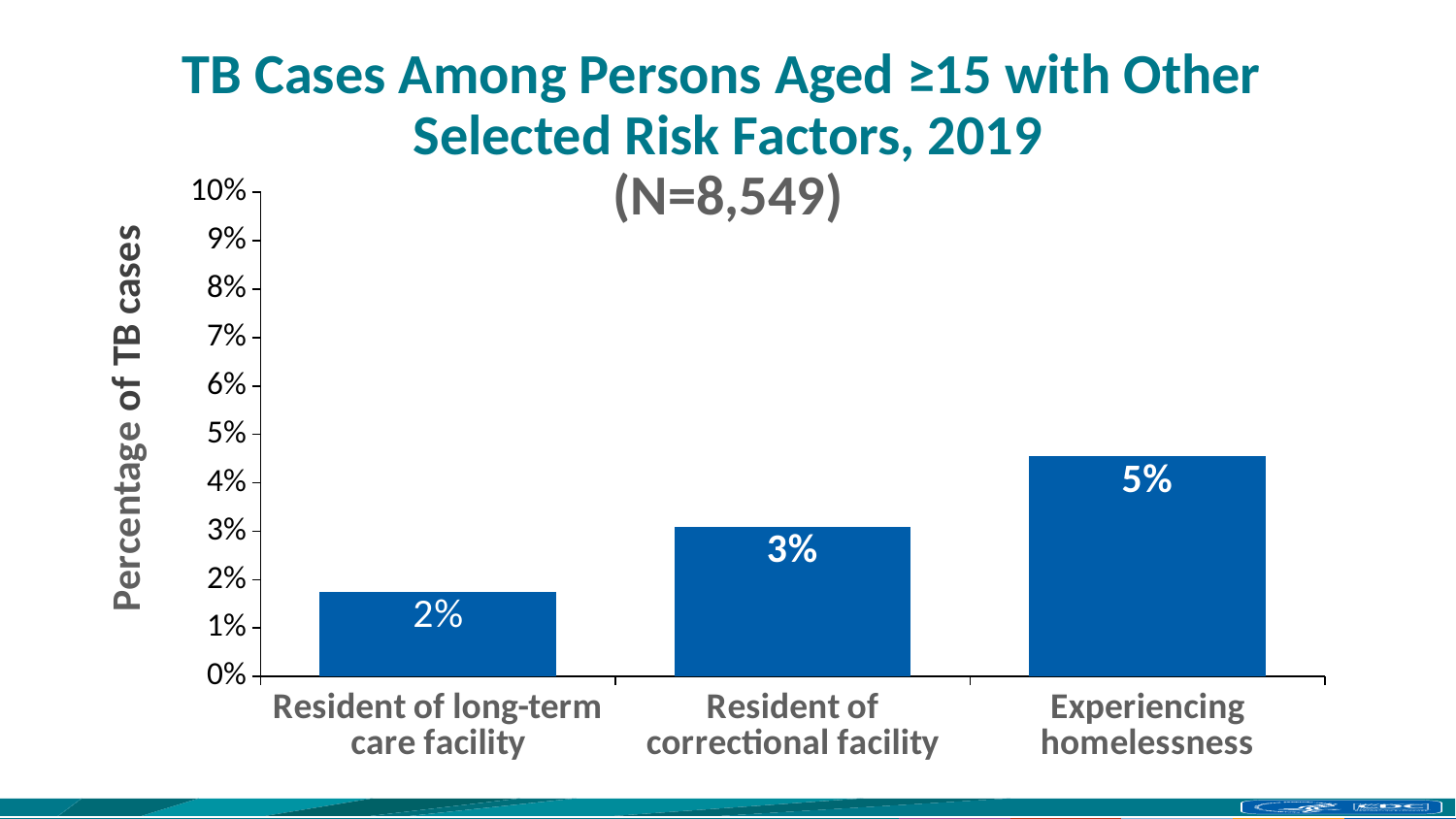
Which is larger: the percentage for residents of a correctional facility or for persons experiencing homelessness? Experiencing homelessness How many risk factor categories are shown in the chart? 3 What is the label on the vertical axis of the chart? Percentage of TB cases What percentage of TB cases is shown for residents of a correctional facility? 3% Which risk factor category has the lowest percentage of TB cases? Resident of long-term care facility What percentage of TB cases is shown for residents of a long-term care facility? 2% What percentage of TB cases is shown for persons experiencing homelessness? 5% Do the values rise or fall moving from left to right across the categories? Rise Is the value for persons experiencing homelessness greater or less than 4%? greater Which risk factor category has the highest percentage of TB cases? Experiencing homelessness Is the value for residents of a correctional facility greater or less than 2%? greater What kind of chart is shown on the slide? Bar chart